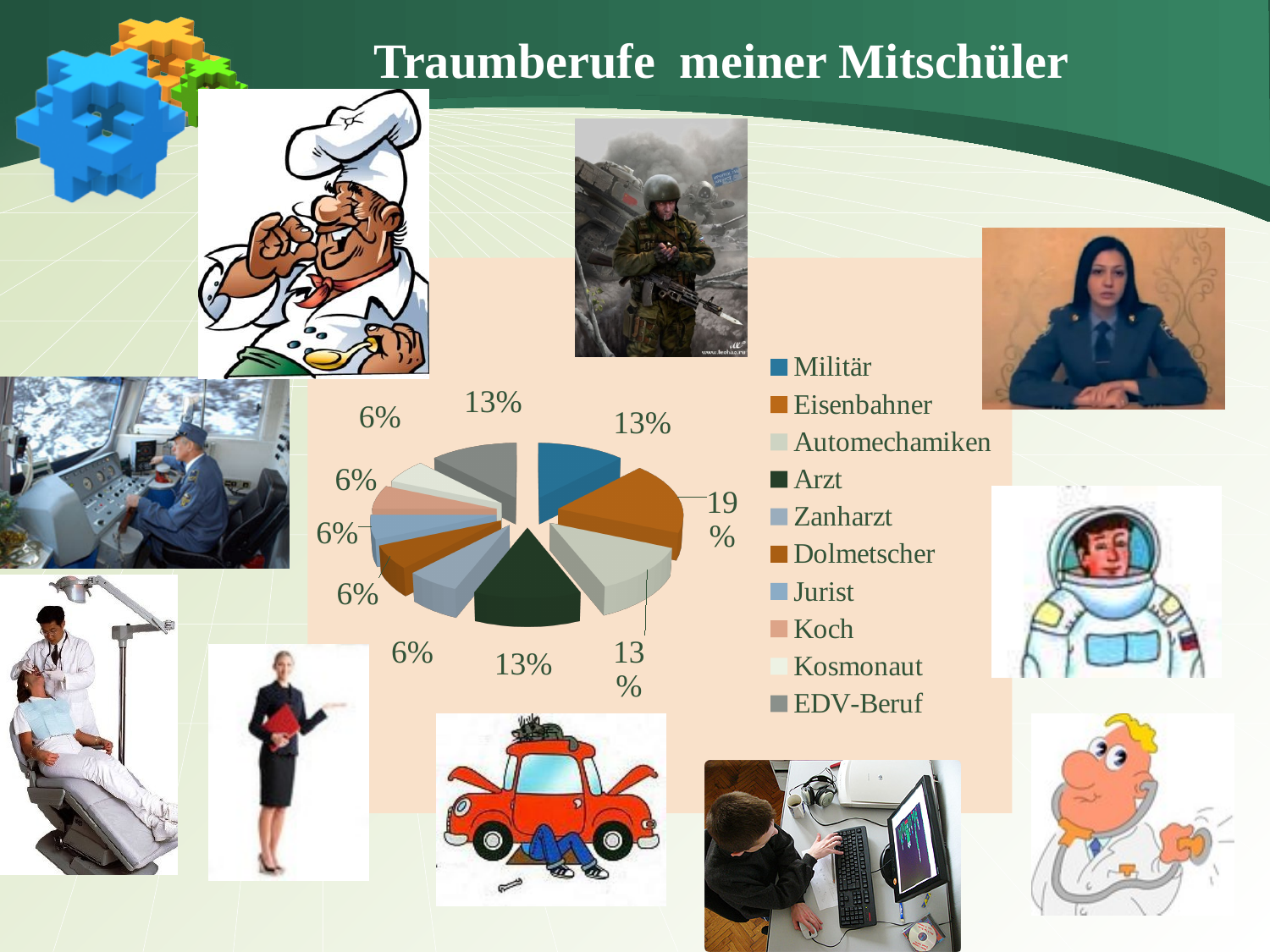
Which category has the largest share in the pie chart? Eisenbahner Which has the larger share, Arzt or Zanharzt? Arzt What is the value shown for Arzt in the pie chart? 13% How many categories does the legend of the pie chart list? 10 What is the difference between the shares of Eisenbahner and Jurist? 13% What is the value shown for Militär in the pie chart? 13% What share of the pie does Eisenbahner have? 19% What kind of chart is shown on the slide? pie chart What colour represents Militär in the pie chart? blue What is the value shown for Koch in the pie chart? 6% What is the title of the slide containing the pie chart? Traumberufe meiner Mitschüler How many slices does the pie chart have? 10